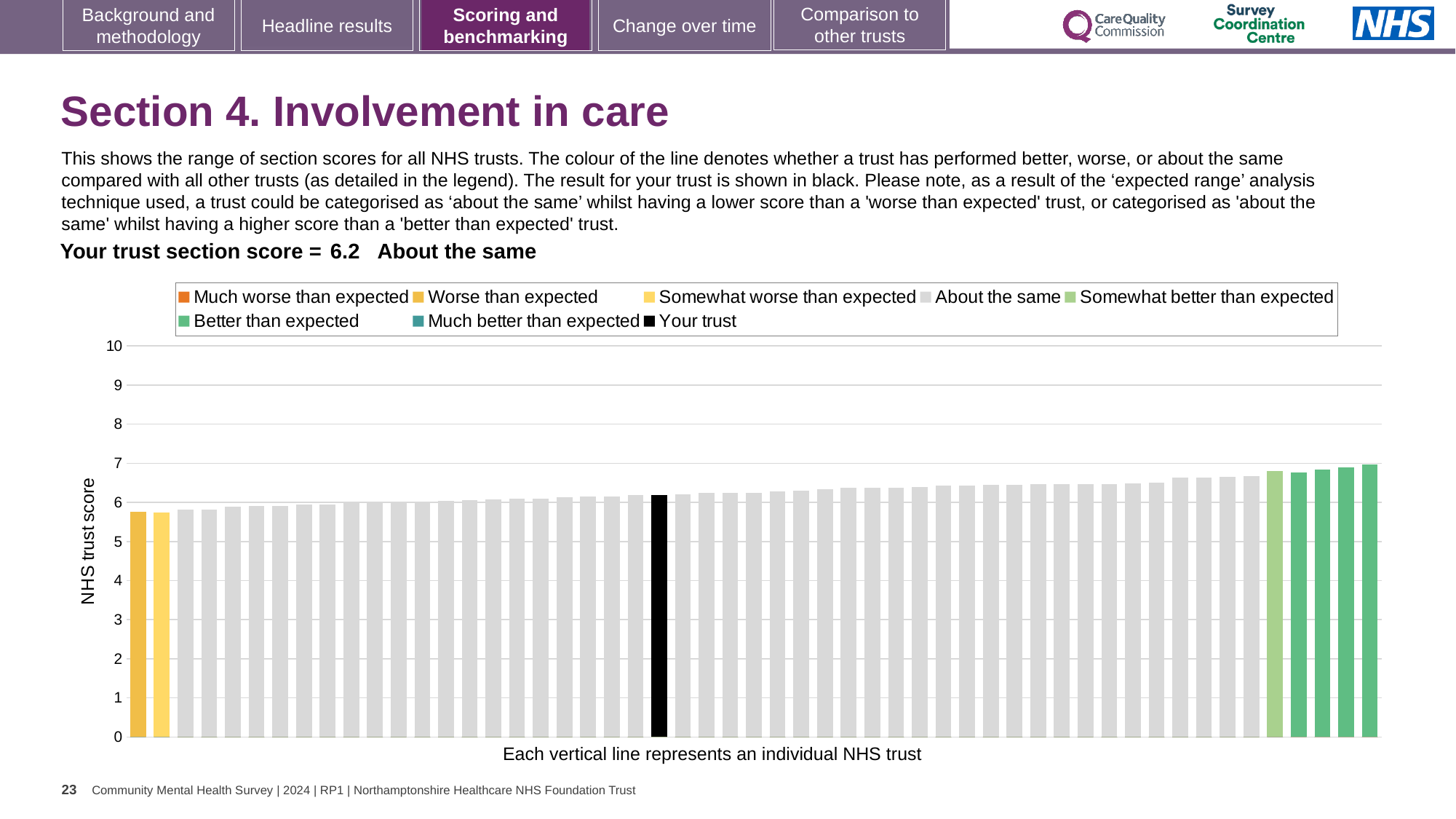
What is the title of the vertical axis? NHS trust score What kind of chart is shown on the slide? Bar chart Do the bar values rise or fall from left to right along the x axis? Rise How many entries does the chart legend list? 8 Is the value of the leftmost bar greater or less than 6? less What is the highest value shown on the vertical axis? 10 Is the value of the leftmost bar greater or less than 5? greater What colour is used for the bar representing your trust? Black Is the value of the black bar (your trust) greater or less than 7? less What is the section score for your trust shown on the chart? 6.2 How is your trust's score categorised compared with other trusts? About the same